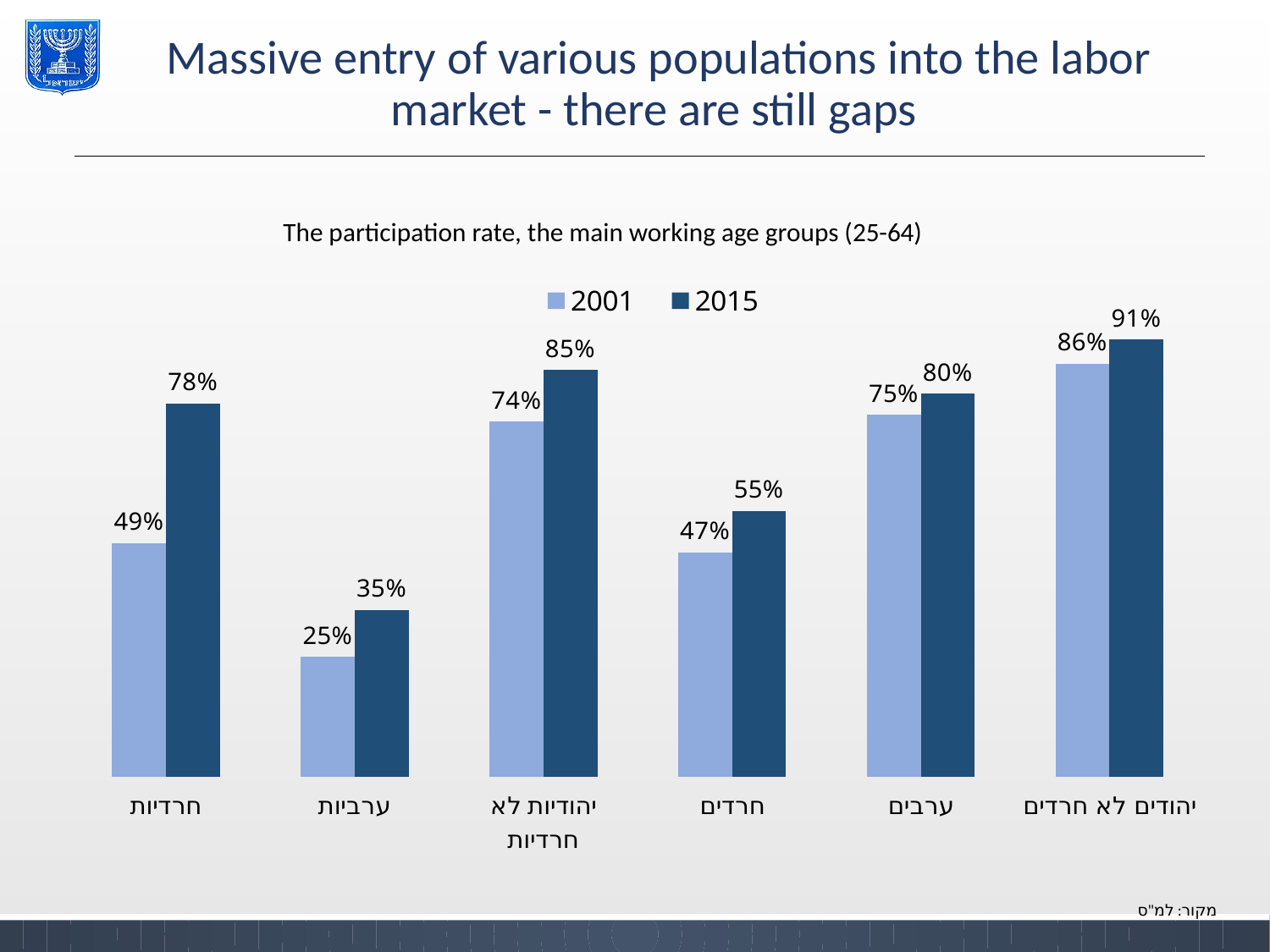
Which is larger, the 2001 value for ערבים or the 2001 value for יהודיות לא חרדיות? ערבים What is the difference between the 2015 and 2001 values for חרדיות? 29% What is the 2015 value for חרדיות? 78% What is the 2001 value for ערביות? 25% Which category has the highest 2015 value? יהודים לא חרדים How many series does the legend list? 2 What is the 2015 value for יהודיות לא חרדיות? 85% How many categories are shown on the x axis? 6 What kind of chart is shown on the slide? Bar chart What is the difference between the 2015 and 2001 values for ערבים? 5% Which category has the lowest 2001 value? ערביות What is the 2001 value for חרדים? 47%